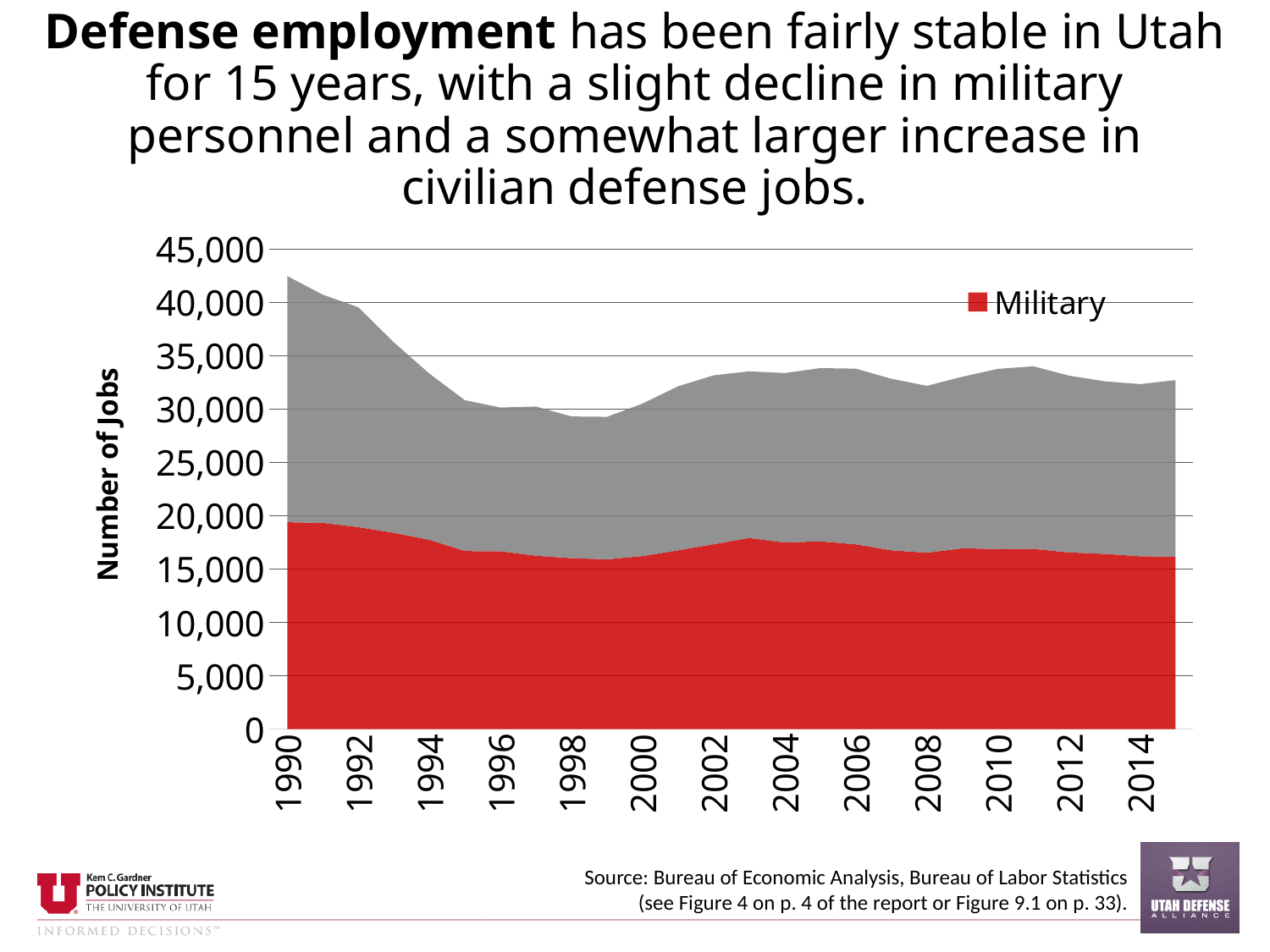
Does the Military series rise or fall from 1990 to 2014? fall Is the total number of jobs in 2000 greater or less than 35,000? less How many year labels are shown along the x axis of the chart? 13 Is the total number of jobs in 2010 greater or less than 30,000? greater Is the Military value in 2014 greater or less than 20,000? less What is the label on the vertical axis of the chart? Number of Jobs How many series does the chart's legend list? 1 In which year is the total number of jobs highest? 1990 What kind of chart is shown on the slide? Area chart Which series name is shown in the chart's legend? Military